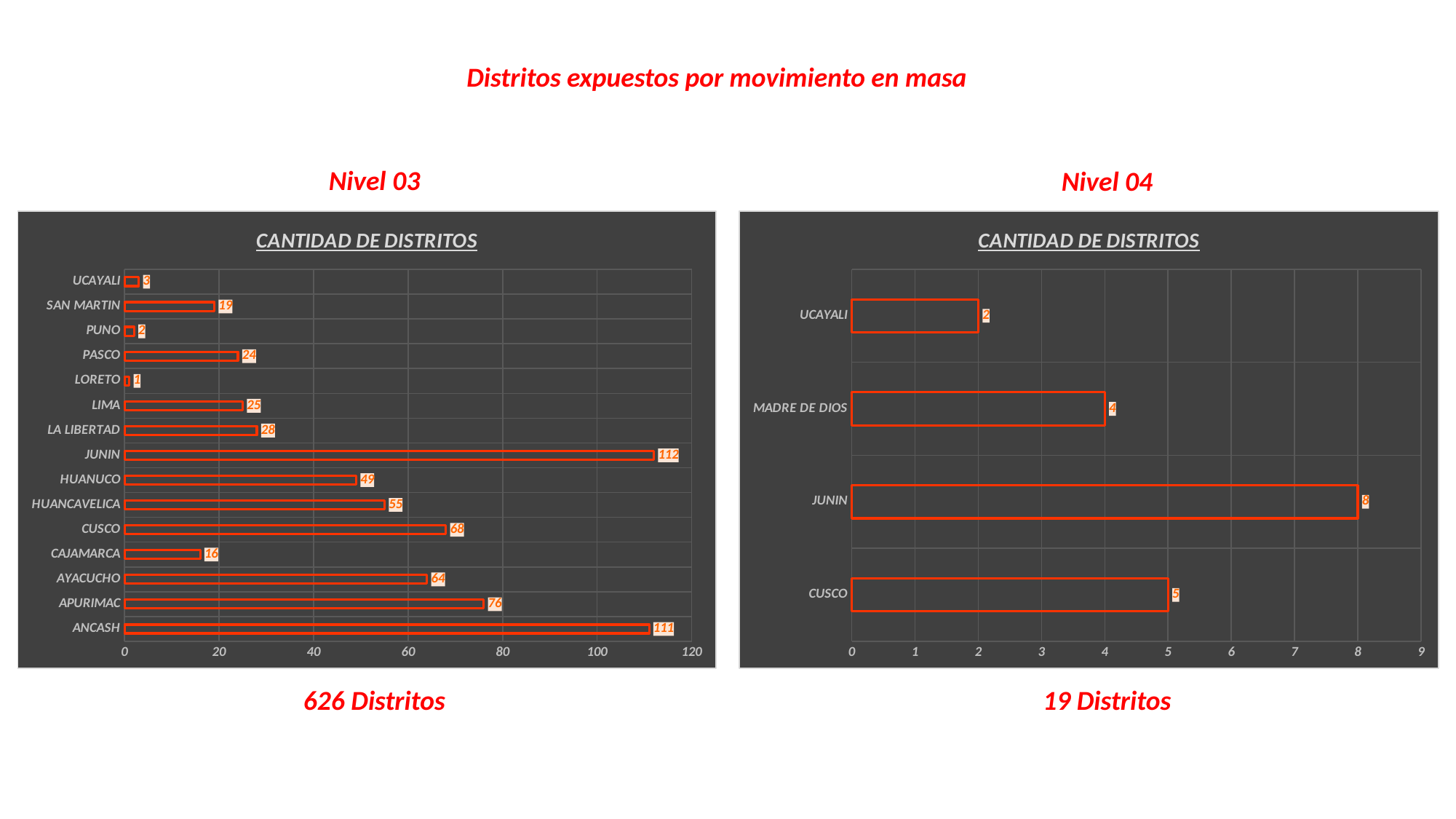
In the Nivel 03 chart, what is the value for HUANCAVELICA? 55 In the Nivel 04 chart, which category has the lowest value? UCAYALI In the Nivel 03 chart, which category has the lowest value? LORETO How many categories are shown in the Nivel 04 chart? 4 In the Nivel 04 chart, what is the difference between the values for JUNIN and CUSCO? 3 How many categories are shown in the Nivel 03 chart? 15 In the Nivel 03 chart, what is the difference between the values for APURIMAC and AYACUCHO? 12 In the Nivel 03 chart, what is the value for CAJAMARCA? 16 What kind of chart is the Nivel 04 chart? Bar chart In the Nivel 04 chart, what is the value for MADRE DE DIOS? 4 In the Nivel 03 chart, which is larger, the value for CUSCO or the value for HUANUCO? CUSCO In the Nivel 04 chart, which category has the highest value? JUNIN